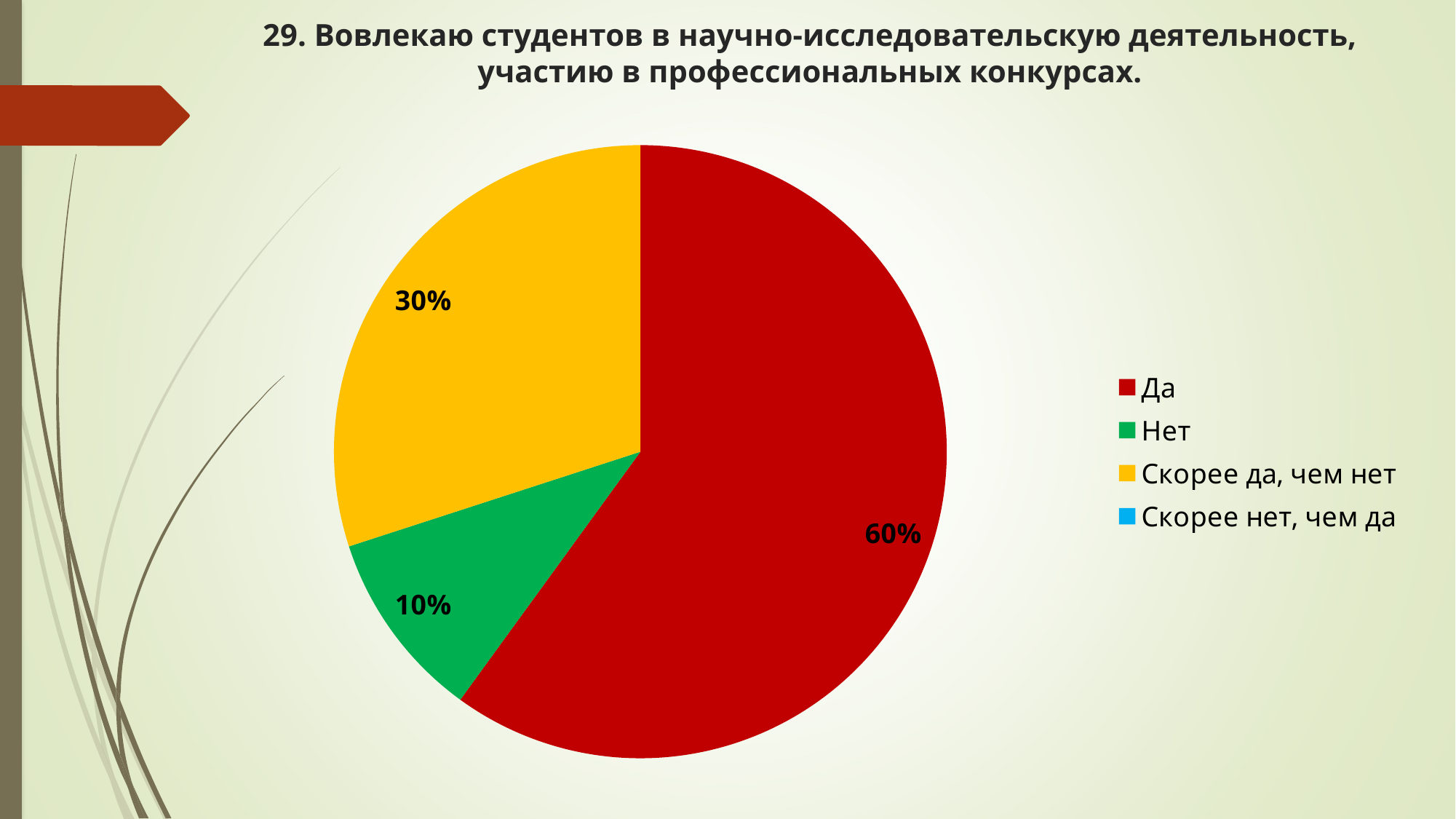
What percentage of the pie is labelled for "Нет"? 10% Which response with a visible slice has the smallest share of the pie? Нет Which slice is larger: "Скорее да, чем нет" or "Нет"? Скорее да, чем нет What type of chart is shown on the slide? pie chart Which response has the largest share of the pie? Да What is the difference in percentage points between the "Да" slice and the "Скорее да, чем нет" slice? 30 What percentage of the pie is labelled for "Скорее да, чем нет"? 30% What percentage of the pie is labelled for "Да"? 60% How many slices with data labels are visible in the pie? 3 What is the title of the chart? 29. Вовлекаю студентов в научно-исследовательскую деятельность, участию в профессиональных конкурсах. How many entries does the legend list? 4 What colour is the slice for "Скорее да, чем нет"? yellow